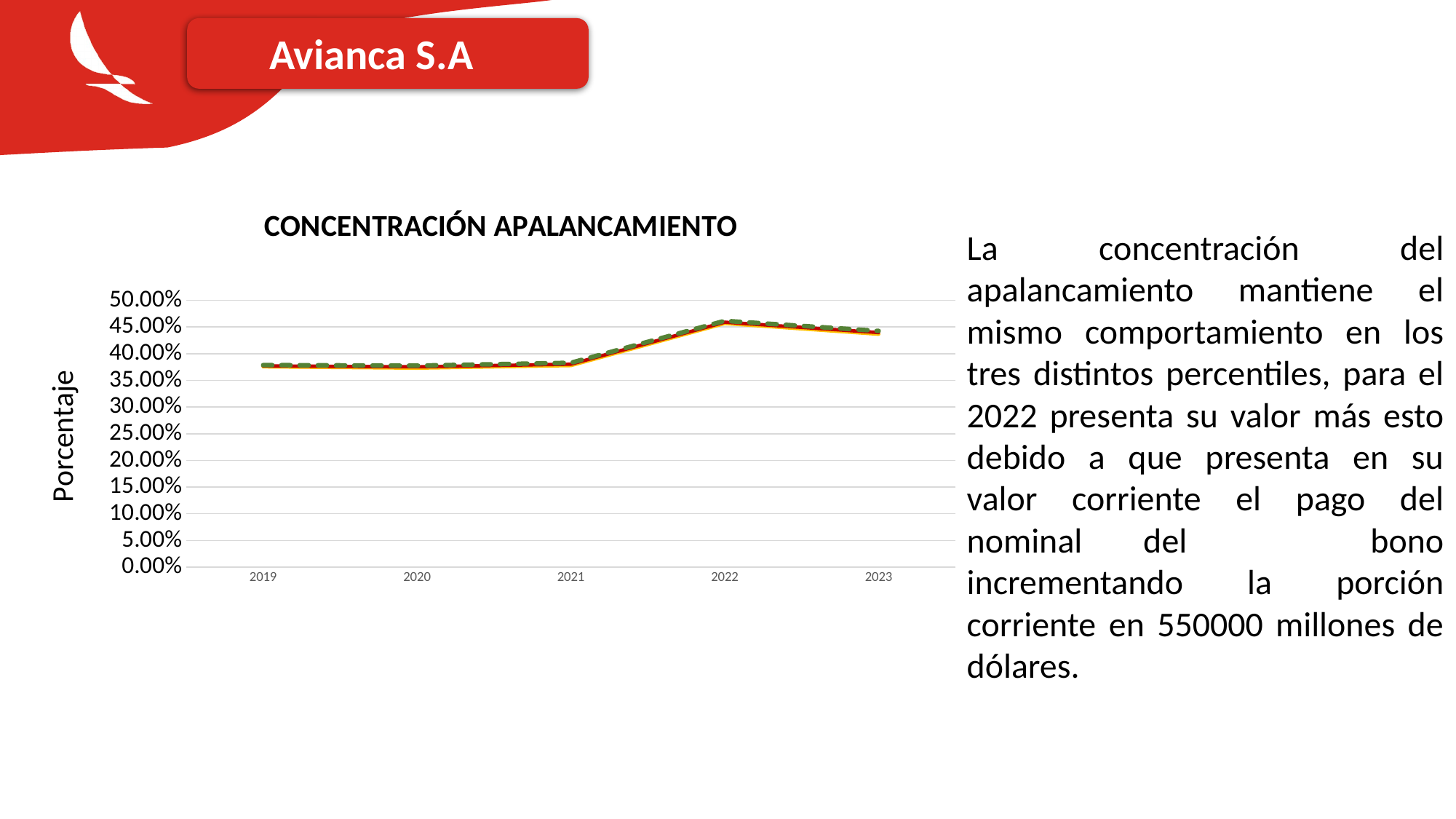
What is the title of the chart? CONCENTRACIÓN APALANCAMIENTO How many years are shown along the x axis of the chart? 5 Do the values rise or fall from 2022 to 2023? fall In which year does the chart reach its highest value? 2022 What kind of chart is shown on the slide? line chart Is the value for 2022 greater or less than 40.00%? greater Do the values rise or fall from 2021 to 2022? rise Is the value for 2021 greater or less than 35.00%? greater Which year has the larger value, 2021 or 2022? 2022 What is the label on the vertical axis of the chart? Porcentaje Is the value for 2023 greater or less than 50.00%? less